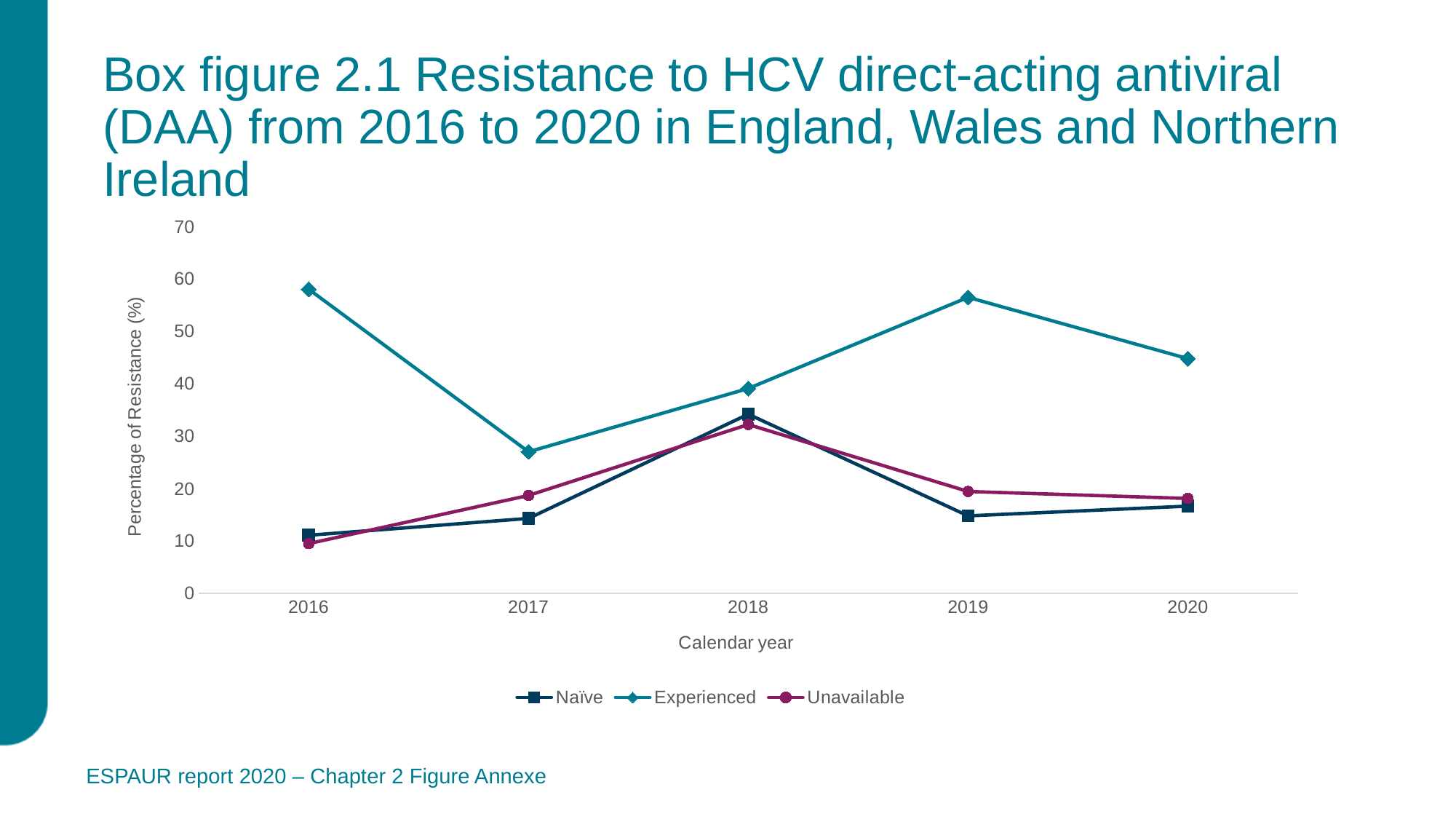
In 2017, which series has the larger value, Unavailable or Naïve? Unavailable In which year is the Naïve series at its highest? 2018 What kind of chart is shown on the slide? Line chart In which year is the Unavailable series at its highest? 2018 How many calendar years are plotted on the x axis? 5 In 2018, which series has the larger value, Experienced or Naïve? Experienced Does the Experienced series rise or fall from 2016 to 2017? Fall In which year is the Experienced series at its lowest? 2017 How many series does the legend list? 3 Is the value for Experienced in 2016 greater or less than 50? greater Is the value for Naïve in 2016 greater or less than 20? less What is the title of the y axis? Percentage of Resistance (%)